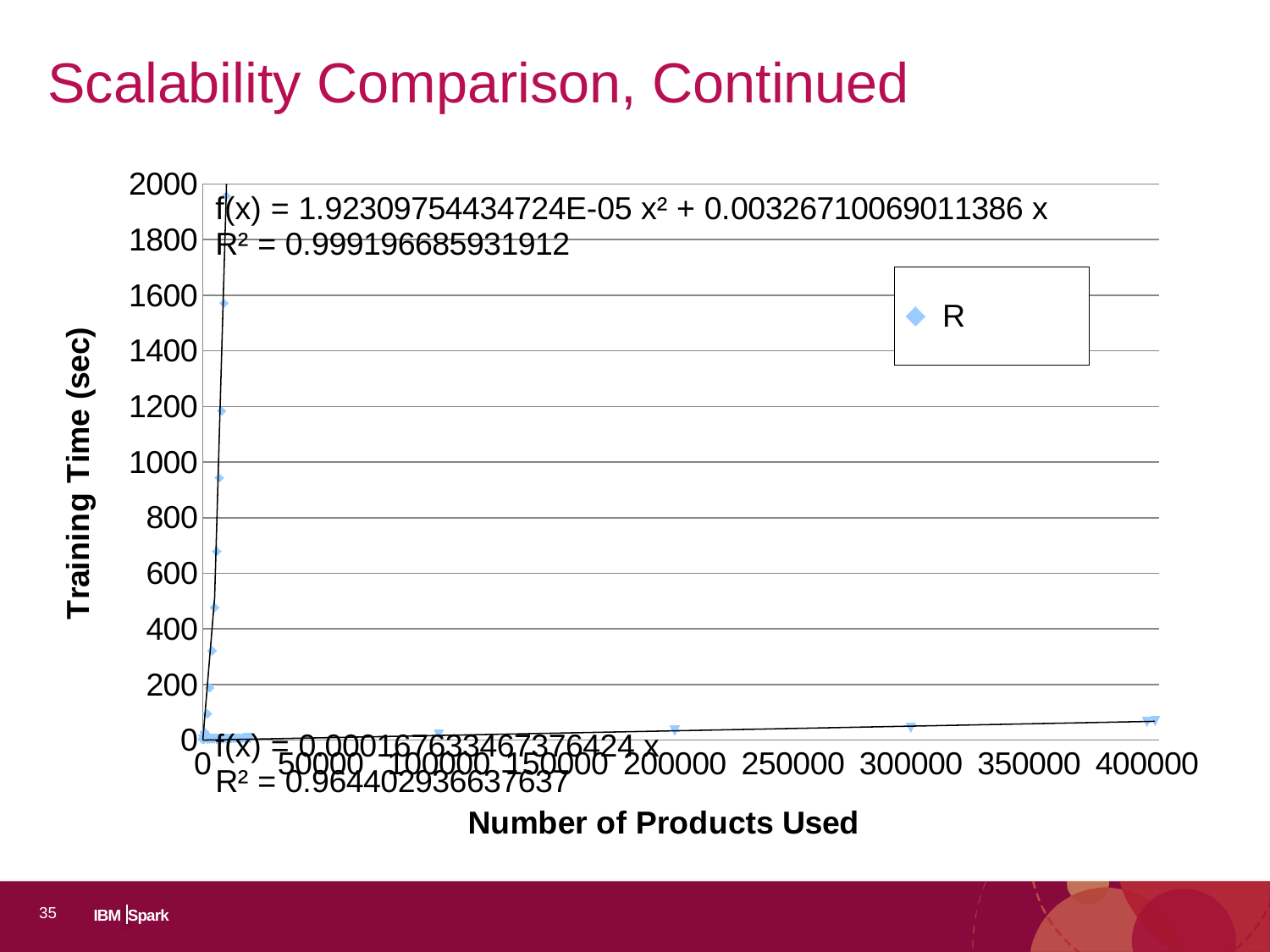
What is the title of the x axis? Number of Products Used What is the highest tick value shown on the x axis? 400000 Is the highest plotted training time for the R series greater or less than 1400? greater How many series does the legend list? 1 What is the highest tick value shown on the y axis? 2000 What is the R² value printed for the lower trendline equation? 0.964402936637637 Does the training time for the R series rise or fall as the number of products used increases? rise Is the training time plotted at about 400000 products greater or less than 200? less What is the R² value printed for the upper trendline equation? 0.999196685931912 Is the highest plotted training time for the R series greater or less than 1800? greater What is the title of the y axis? Training Time (sec) What kind of chart is shown on the slide? scatter chart